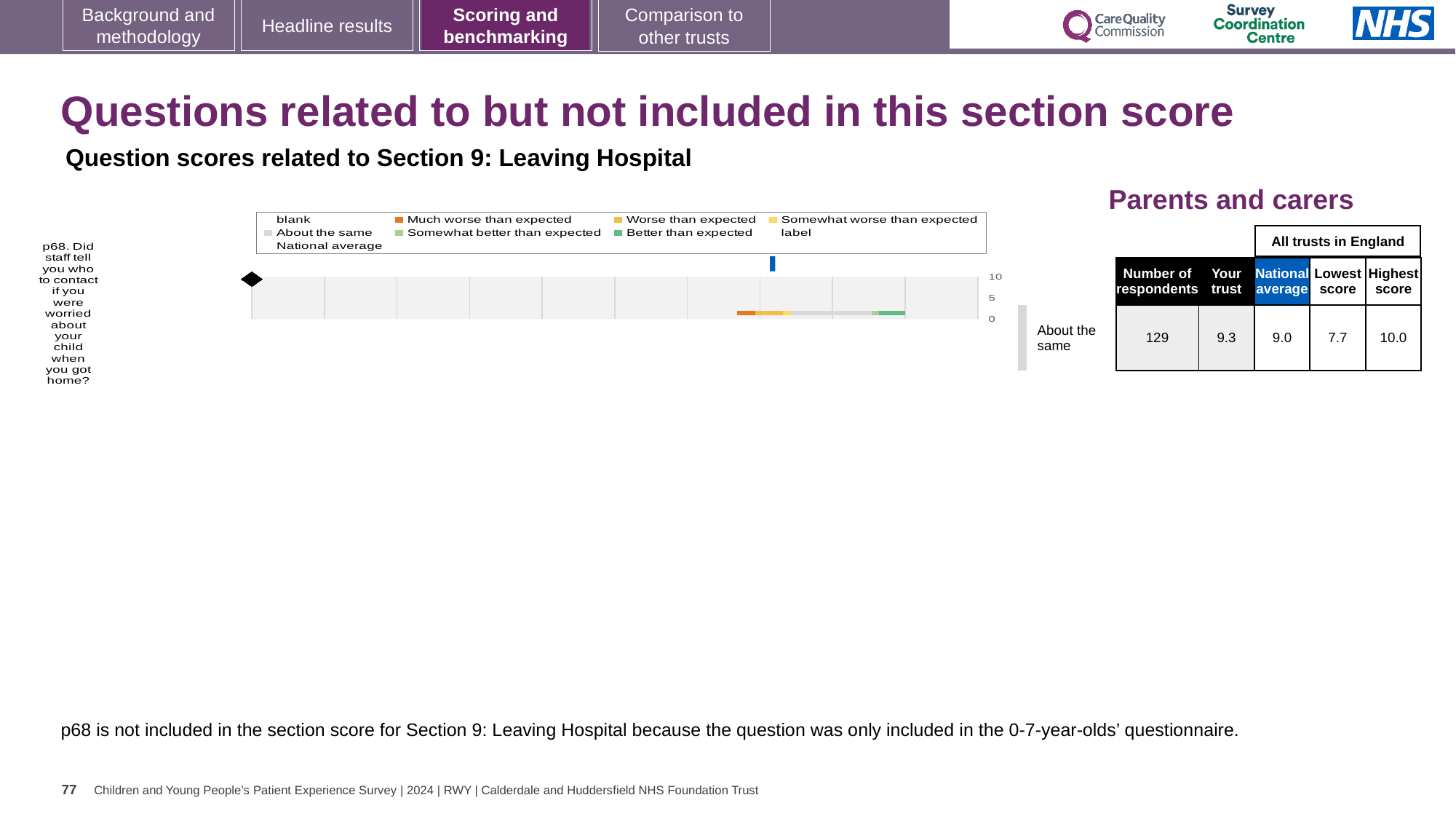
How many survey questions are plotted in the chart? 1 Which is larger for p68, the trust's score or the national average? Your trust Which benchmark category does the trust's result for p68 fall into? About the same What is the difference between the trust's score and the national average for p68? 0.3 How many respondents answered question p68? 129 What is the maximum value shown on the chart's score axis? 10 What is the difference between the highest and lowest scores for p68 across all trusts in England? 2.3 What kind of chart is shown for question p68? bar chart What is the trust's score for p68 shown in the table next to the chart? 9.3 What is the highest score among all trusts in England for p68? 10.0 What is the national average score for p68? 9.0 What is the lowest score among all trusts in England for p68? 7.7